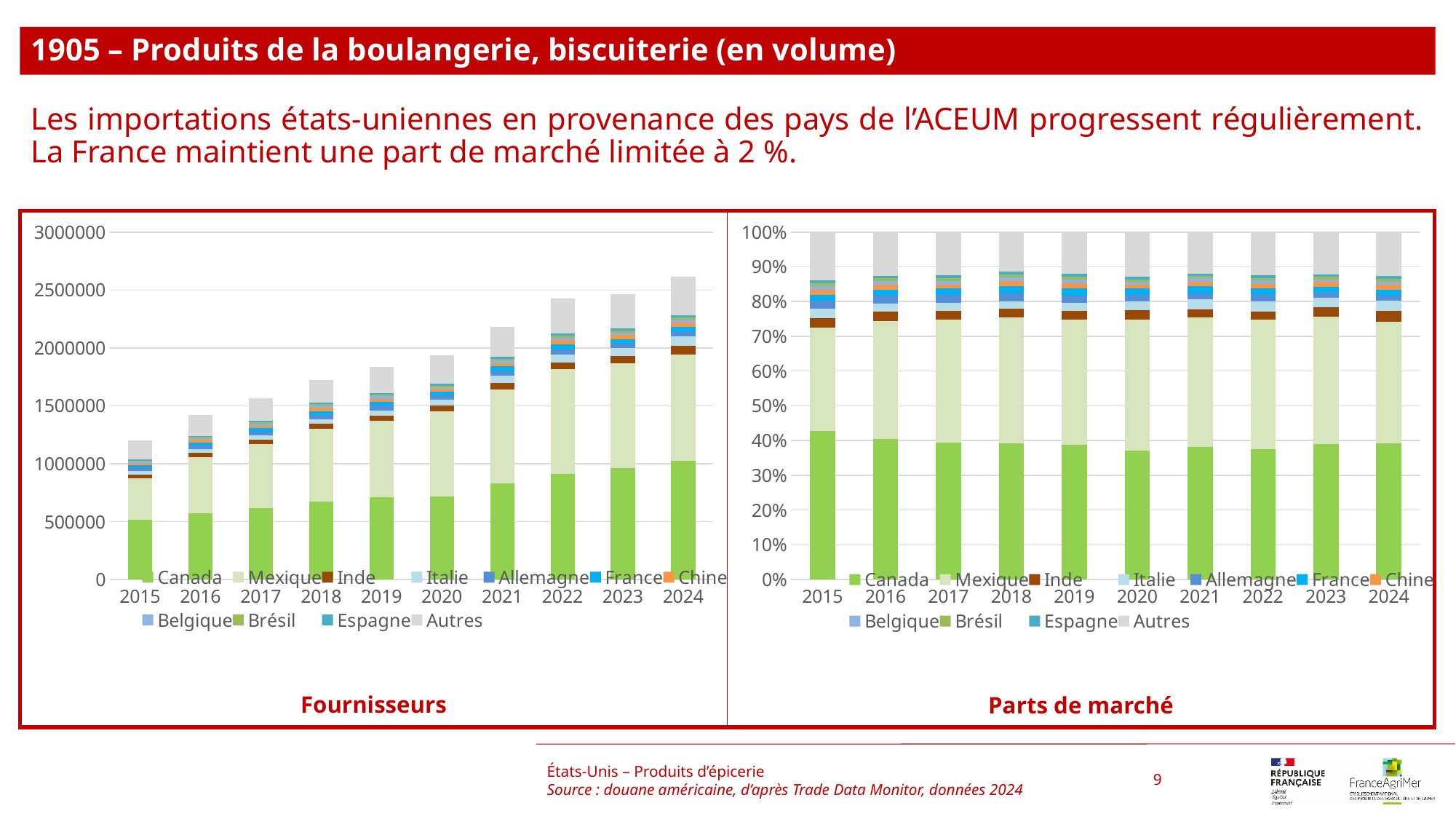
In the 'Fournisseurs' chart, is the Canada segment for 2015 greater or less than 1000000? less How many series does the legend of the 'Parts de marché' chart list? 11 In the 'Parts de marché' chart, is the Canada share for 2015 greater or less than 40%? greater In the 'Fournisseurs' chart, is the total bar for 2024 greater or less than 2500000? greater In the 'Fournisseurs' chart, which year has the lowest total bar? 2015 What kind of chart is the 'Fournisseurs' chart on the left? stacked bar chart How many years are shown on the x axis of the 'Fournisseurs' chart? 10 In the 'Fournisseurs' chart, which total bar is larger, 2015 or 2024? 2024 What is the title of the chart on the right side of the slide? Parts de marché In the 'Fournisseurs' chart, which year has the highest total bar? 2024 In the 'Fournisseurs' chart, do the total bars rise or fall from 2015 to 2024? rise